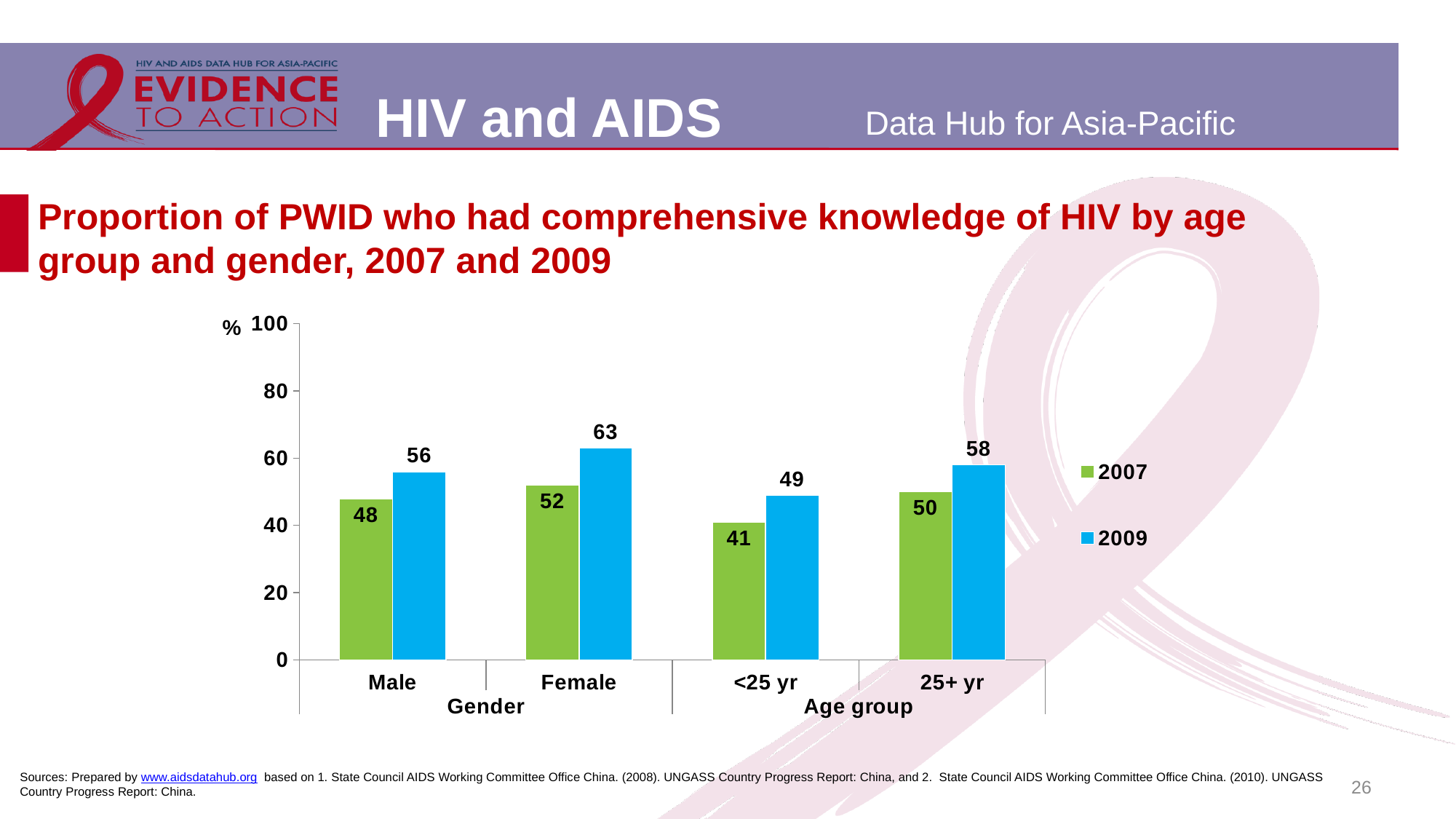
What is the difference between the female and male values in 2009? 7 How many categories are shown on the x axis? 4 What was the value for female PWID in 2007? 52 Which category had the highest value in 2009? Female What was the value for the <25 yr age group in 2007? 41 What was the proportion of male PWID with comprehensive knowledge of HIV in 2009? 56 Which colour represents the 2009 series? Blue By how many percentage points did the value for the 25+ yr group increase from 2007 to 2009? 8 Which category had the lowest value in 2007? <25 yr What kind of chart is shown on the slide? Bar chart How many series does the legend list? 2 Which was larger in 2007: the value for Male or the value for 25+ yr? 25+ yr